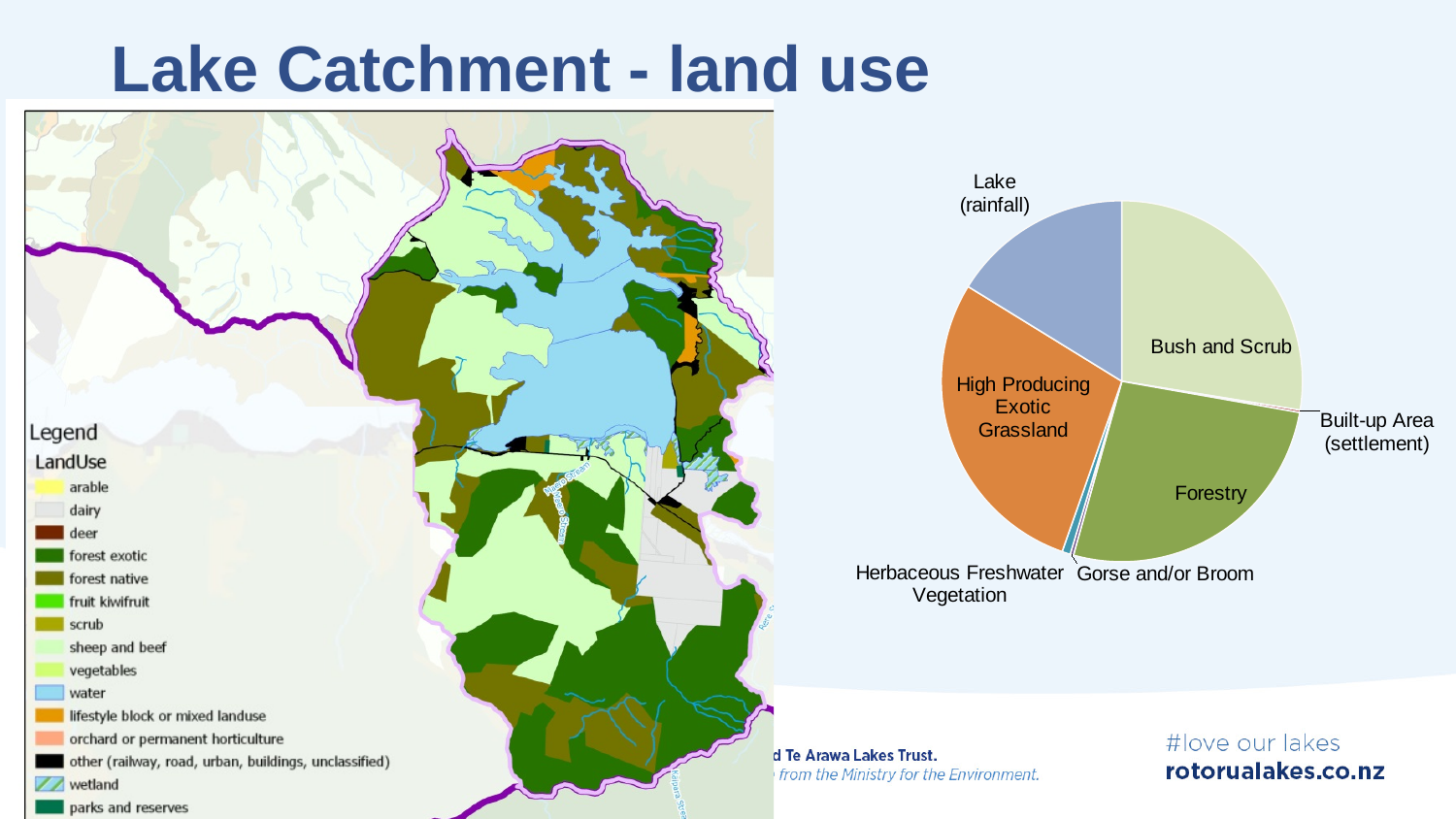
What is the title of the slide containing the pie chart? Lake Catchment - land use In the pie chart, which is larger: the Built-up Area (settlement) slice or the Forestry slice? Forestry What colour is the High Producing Exotic Grassland slice in the pie chart? orange In the pie chart, which is larger: the Lake (rainfall) slice or the High Producing Exotic Grassland slice? High Producing Exotic Grassland How many slices does the pie chart have? 7 In the pie chart, which is larger: the Herbaceous Freshwater Vegetation slice or the Forestry slice? Forestry What kind of chart is shown on the right side of the slide? pie chart